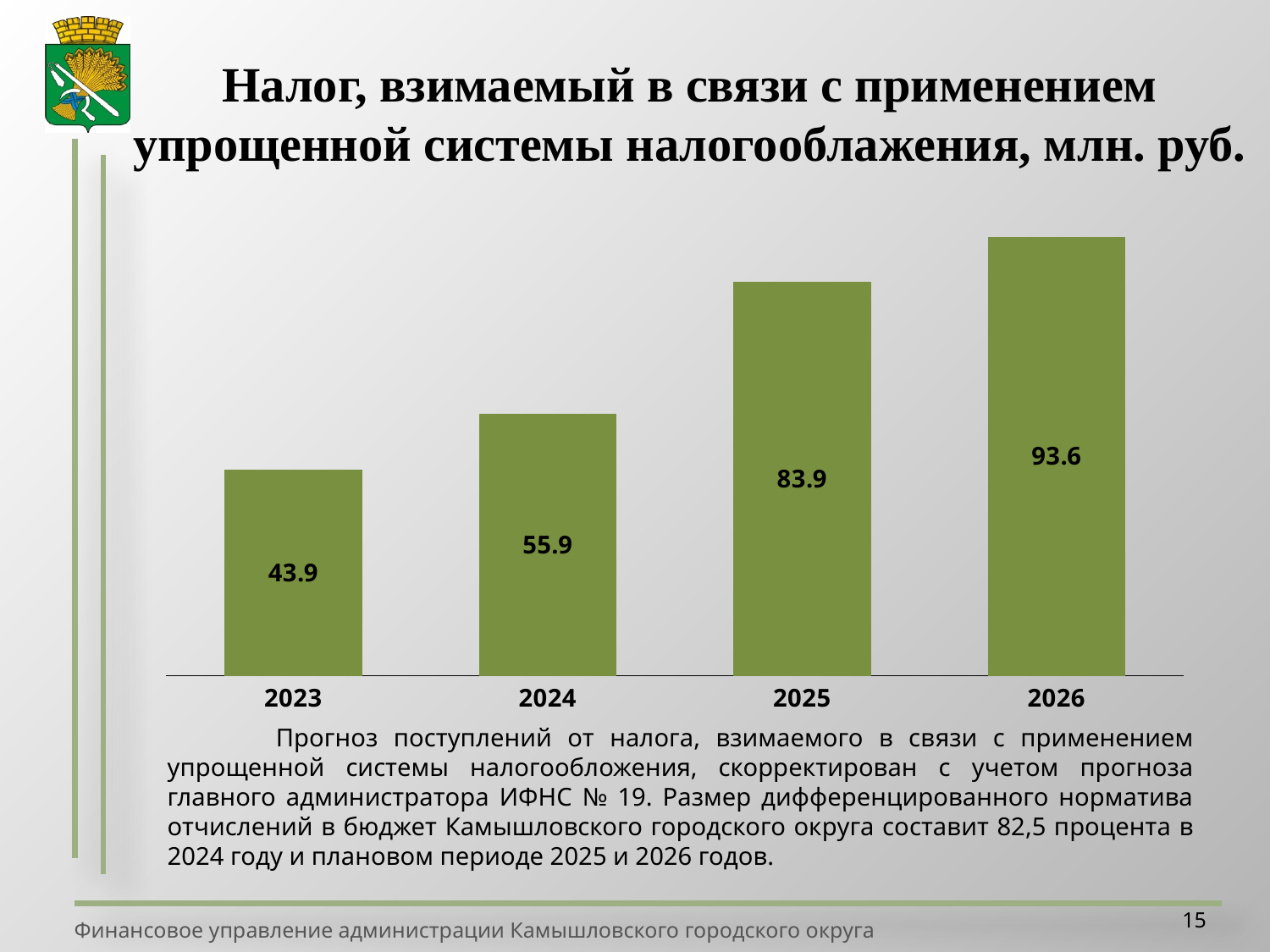
What is the value for 2025? 83.9 Do the values rise or fall from 2023 to 2026? rise What kind of chart is shown on the slide? bar chart How many years are shown on the chart? 4 What is the difference between the values for 2026 and 2023? 49.7 Which is larger, the value for 2024 or the value for 2025? 2025 Which year has the lowest value? 2023 Which year has the highest value? 2026 What is the value for 2026? 93.6 What is the difference between the values for 2025 and 2024? 28 What unit is given in the chart title? млн. руб. What is the value for 2023? 43.9